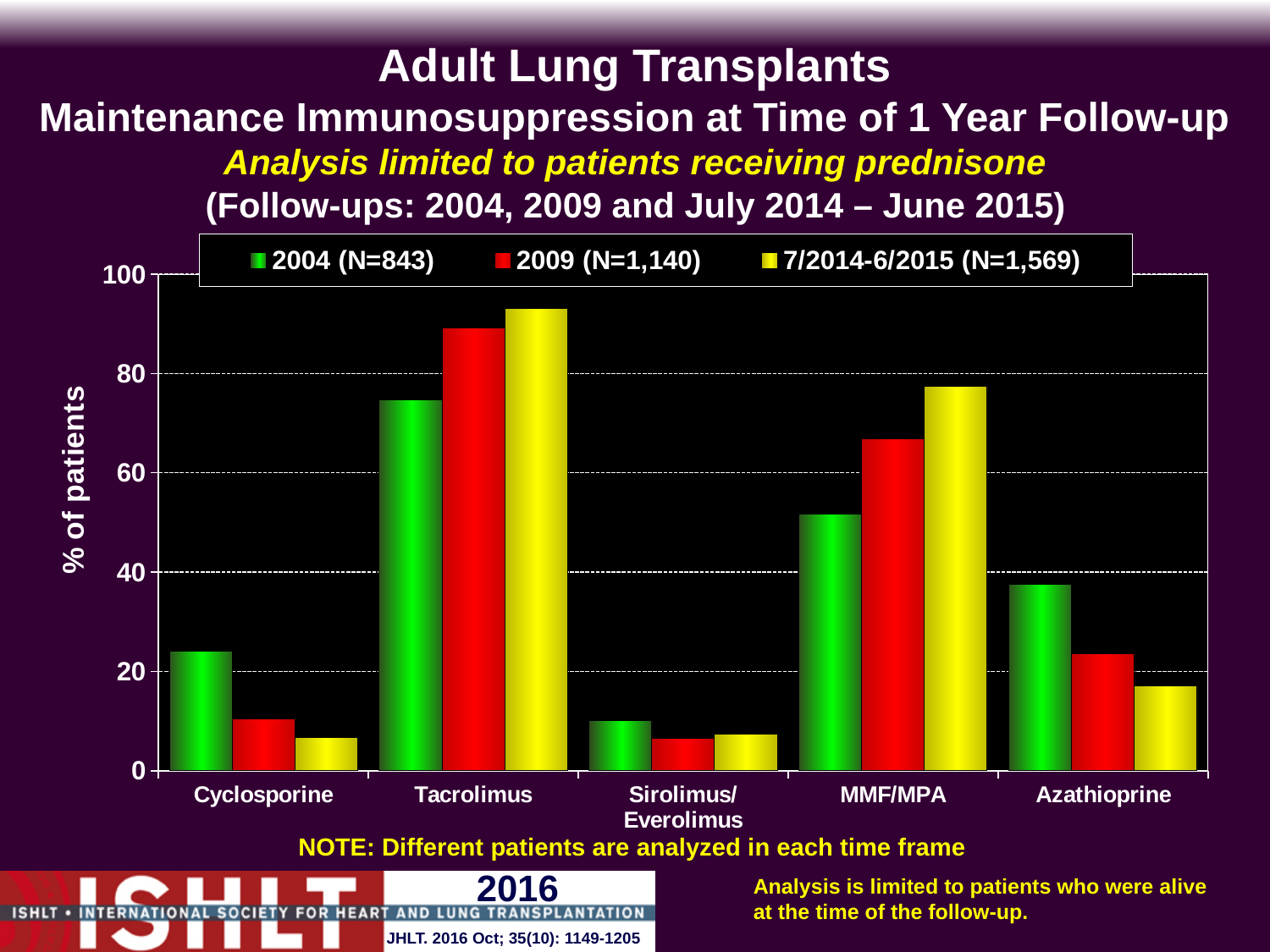
What is the label on the y axis? % of patients For the 2004 series, which is larger: Cyclosporine or Azathioprine? Azathioprine Which category has the lowest value for the 2009 series? Sirolimus/Everolimus Do the values for MMF/MPA rise or fall from 2004 to 7/2014-6/2015? rise Is the value for Tacrolimus in 2004 greater or less than 80? less How many series does the legend list? 3 What kind of chart is shown on the slide? bar chart Is the value for MMF/MPA in 2009 greater or less than 60? greater Is the value for Azathioprine in 7/2014-6/2015 greater or less than 20? less How many drug categories are shown on the x axis? 5 Do the values for Cyclosporine rise or fall from 2004 to 7/2014-6/2015? fall Which category has the highest value for the 7/2014-6/2015 series? Tacrolimus